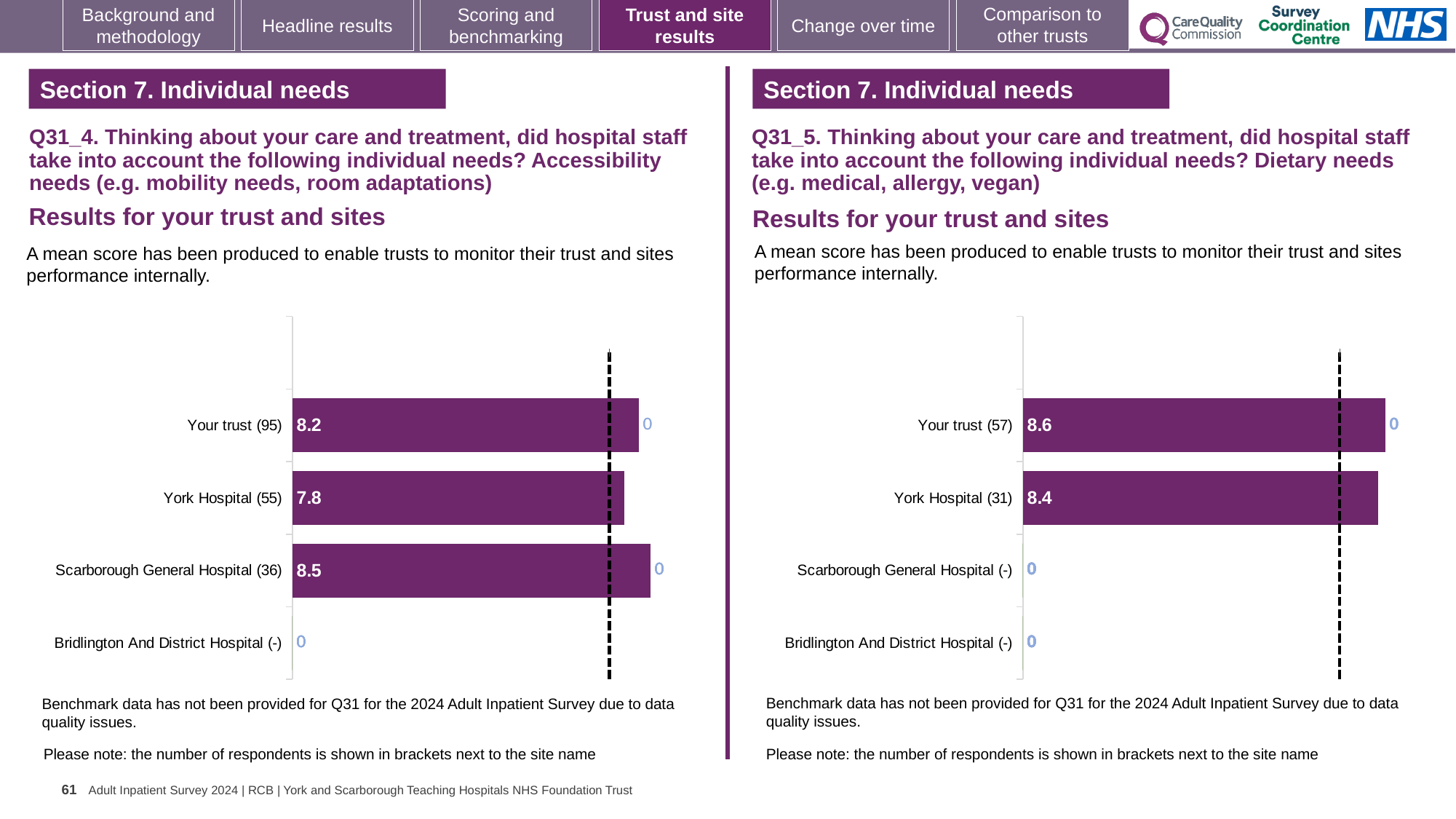
On the right chart (Q31_5, Dietary needs), what is the difference between the scores for Your trust and York Hospital? 0.2 On the left chart (Q31_4, Accessibility needs), what is the difference between the scores for Scarborough General Hospital and York Hospital? 0.7 On the left chart (Q31_4, Accessibility needs), which is larger: the score for Your trust or for York Hospital? Your trust On the left chart (Q31_4, Accessibility needs), what is the mean score for Scarborough General Hospital? 8.5 On the left chart (Q31_4, Accessibility needs), what is the mean score for York Hospital? 7.8 On the left chart (Q31_4, Accessibility needs), which site has the highest mean score? Scarborough General Hospital On the right chart (Q31_5, Dietary needs), what is the mean score for York Hospital? 8.4 On the left chart (Q31_4, Accessibility needs), what is the mean score for Your trust? 8.2 What type of chart is used on the left side of the slide (Q31_4)? Bar chart On the right chart (Q31_5, Dietary needs), what is the mean score for Your trust? 8.6 On the right chart (Q31_5, Dietary needs), how many respondents are shown in brackets for Your trust? 57 How many site categories are listed on the left chart (Q31_4, Accessibility needs)? 4